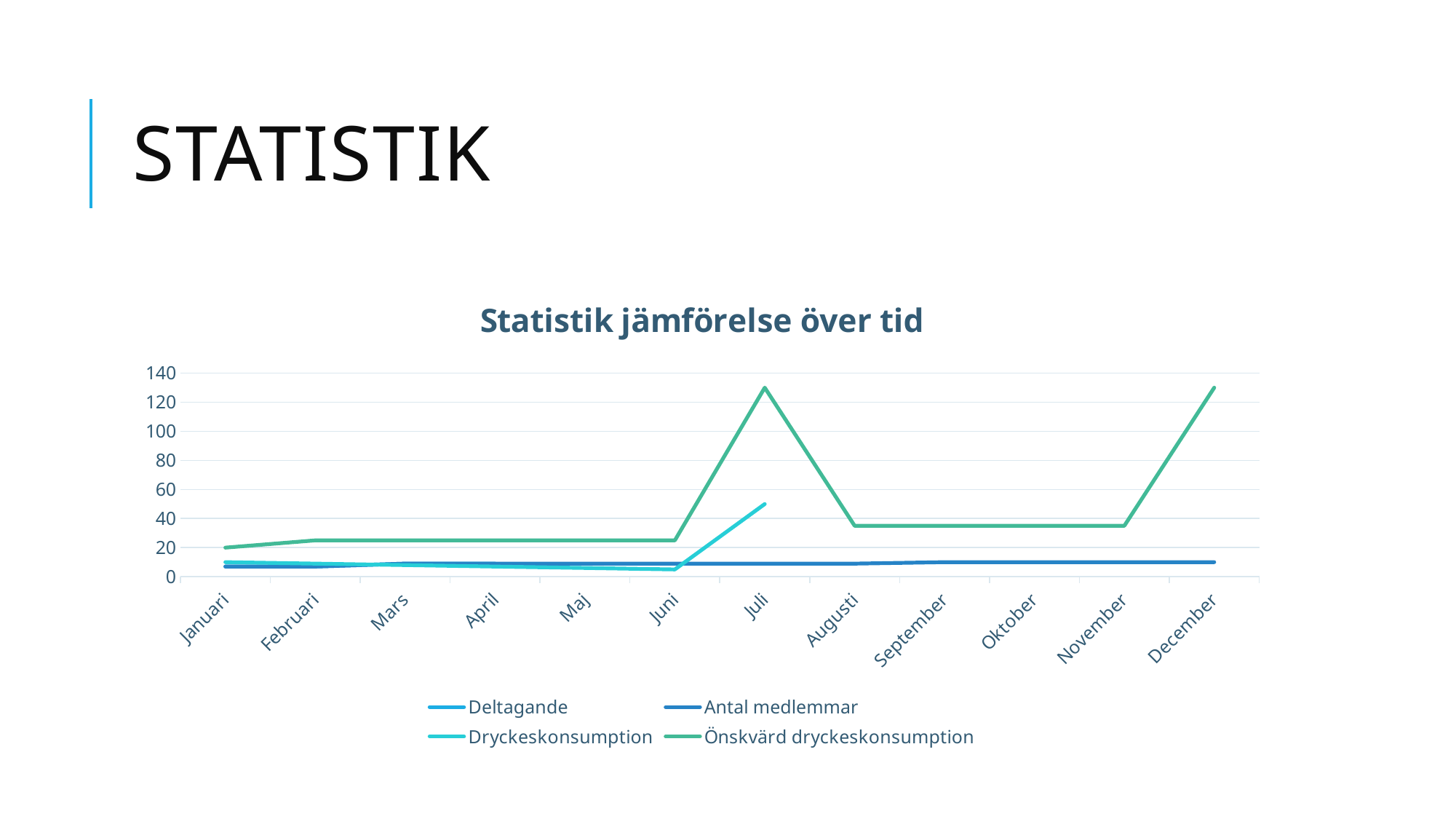
Is the value for Önskvärd dryckeskonsumption in Juli greater or less than 100? greater How many series does the legend list? 4 In which month is Önskvärd dryckeskonsumption lowest? Januari Does Önskvärd dryckeskonsumption rise or fall from November to December? rise How many months are shown on the x axis? 12 Is the value for Dryckeskonsumption in Juli greater or less than 40? greater In Juli, which is larger: Önskvärd dryckeskonsumption or Antal medlemmar? Önskvärd dryckeskonsumption Does Önskvärd dryckeskonsumption rise or fall from Juli to Augusti? fall Is the value for Önskvärd dryckeskonsumption in Augusti greater or less than 60? less What is the title of the chart? Statistik jämförelse över tid What kind of chart is shown on the slide? line chart